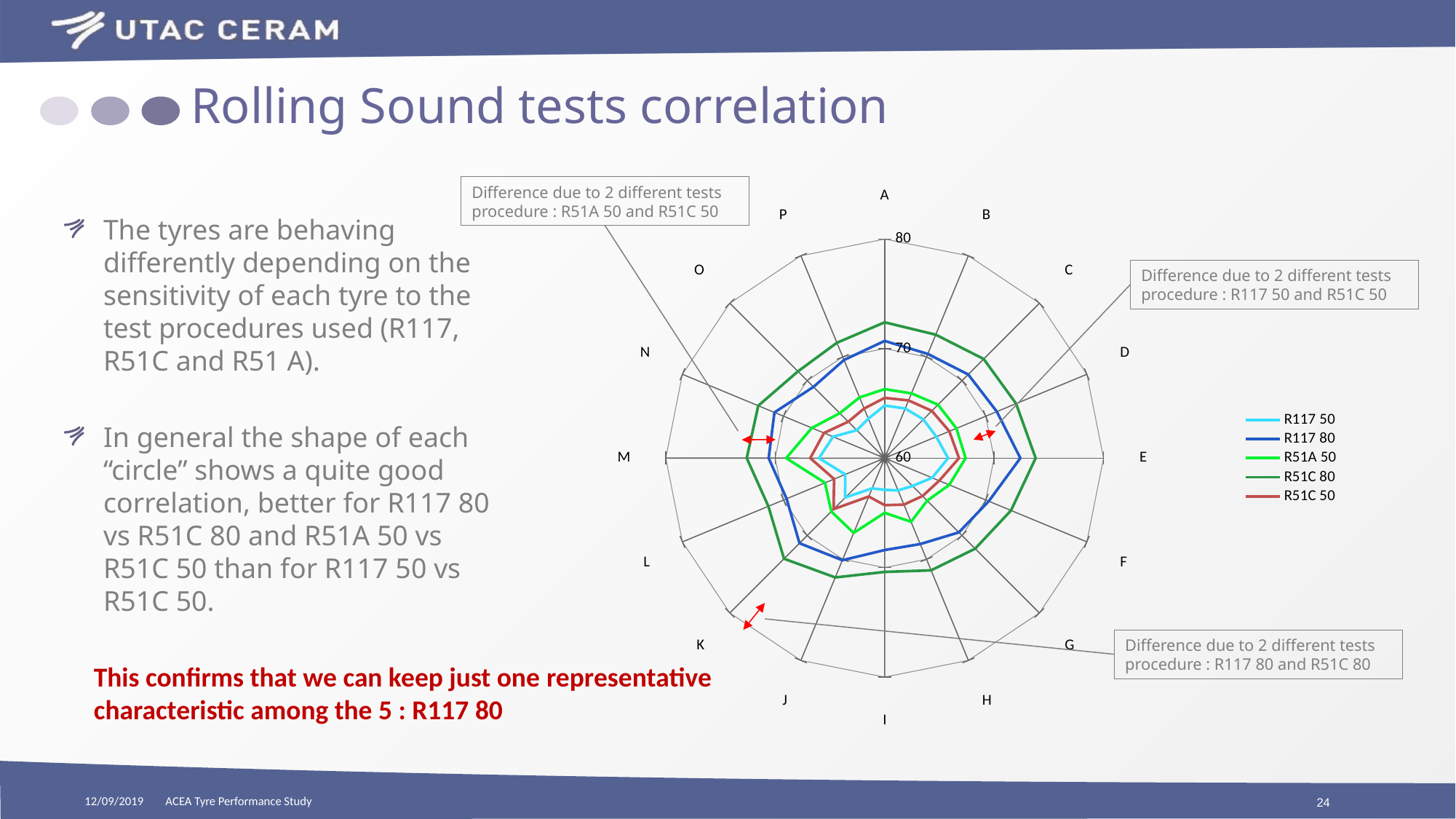
Is the value of R117 50 at category A greater or less than 70? less Is the value of R51A 50 at category E greater or less than 70? less What is the highest value labelled on the radar chart's radial axis? 80 How many categories (axes) does the radar chart have? 16 Which series forms the outermost line on the radar chart, i.e. has the highest values overall? R51C 80 Is the value of R51C 80 at category M greater or less than 70? greater Which series forms the innermost line on the radar chart, i.e. has the lowest values overall? R117 50 What kind of chart is shown on the slide? Radar chart At category A, which series has the larger value: R51C 80 or R117 50? R51C 80 How many series does the chart legend list? 5